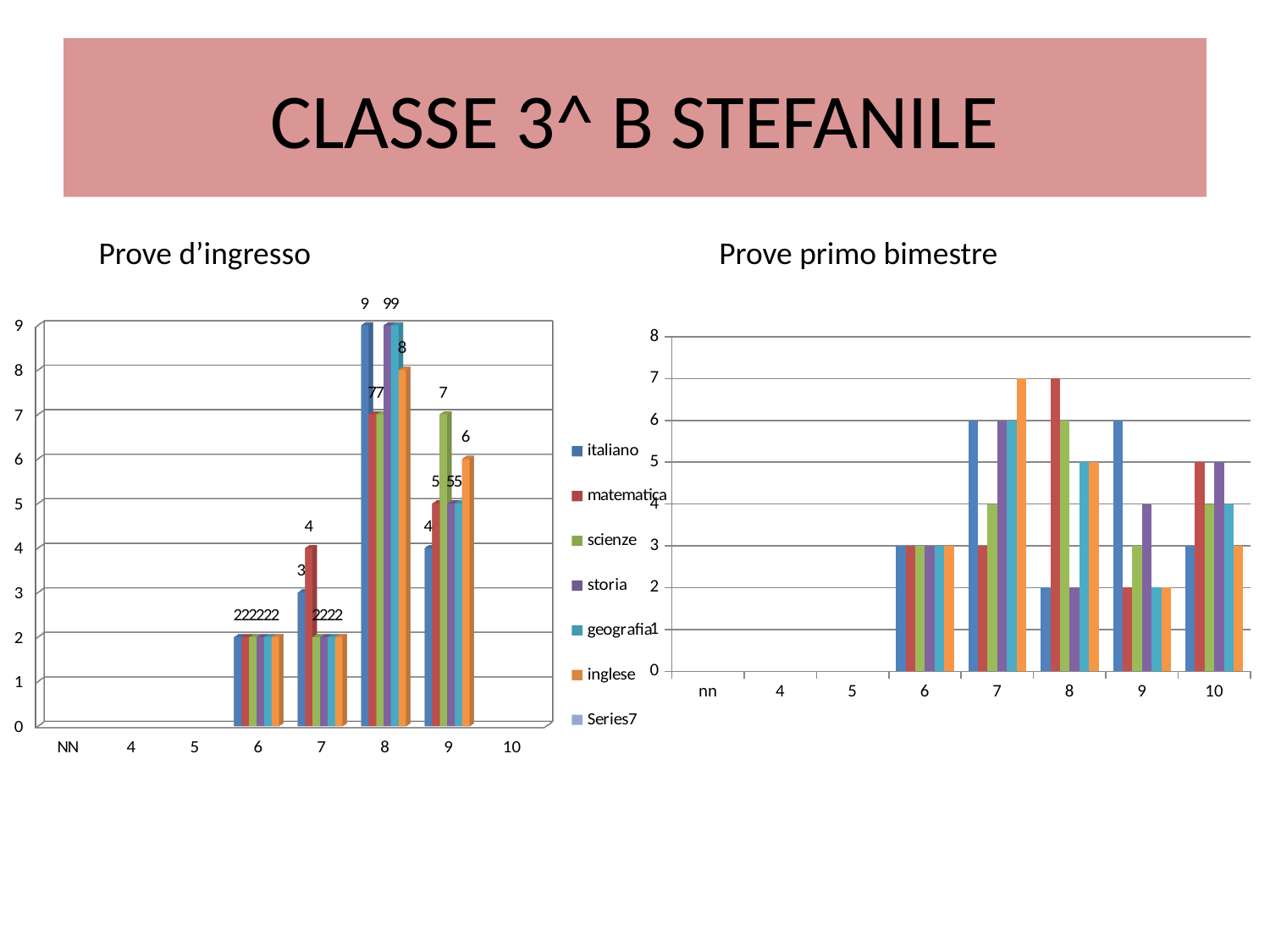
In the 'Prove primo bimestre' chart, is the value for matematica at category 8 greater or less than 5? greater How many series does the legend between the two charts list? 7 In the 'Prove d'ingresso' chart, what is the value for italiano at category 8? 9 In the 'Prove d'ingresso' chart, which category has the highest value for italiano? 8 In the 'Prove d'ingresso' chart, what is the difference between the inglese value at category 8 and the inglese value at category 9? 2 In the 'Prove d'ingresso' chart, what is the value for matematica at category 7? 4 In the 'Prove d'ingresso' chart, what is the value for scienze at category 9? 7 In the 'Prove primo bimestre' chart, what is the value for inglese at category 7? 7 How many categories are shown on the x axis of the 'Prove primo bimestre' chart? 8 In the 'Prove d'ingresso' chart, at category 7, which is larger: italiano or matematica? matematica What kind of chart is the 'Prove d'ingresso' chart? bar chart In the 'Prove primo bimestre' chart, what is the value for italiano at category 9? 6